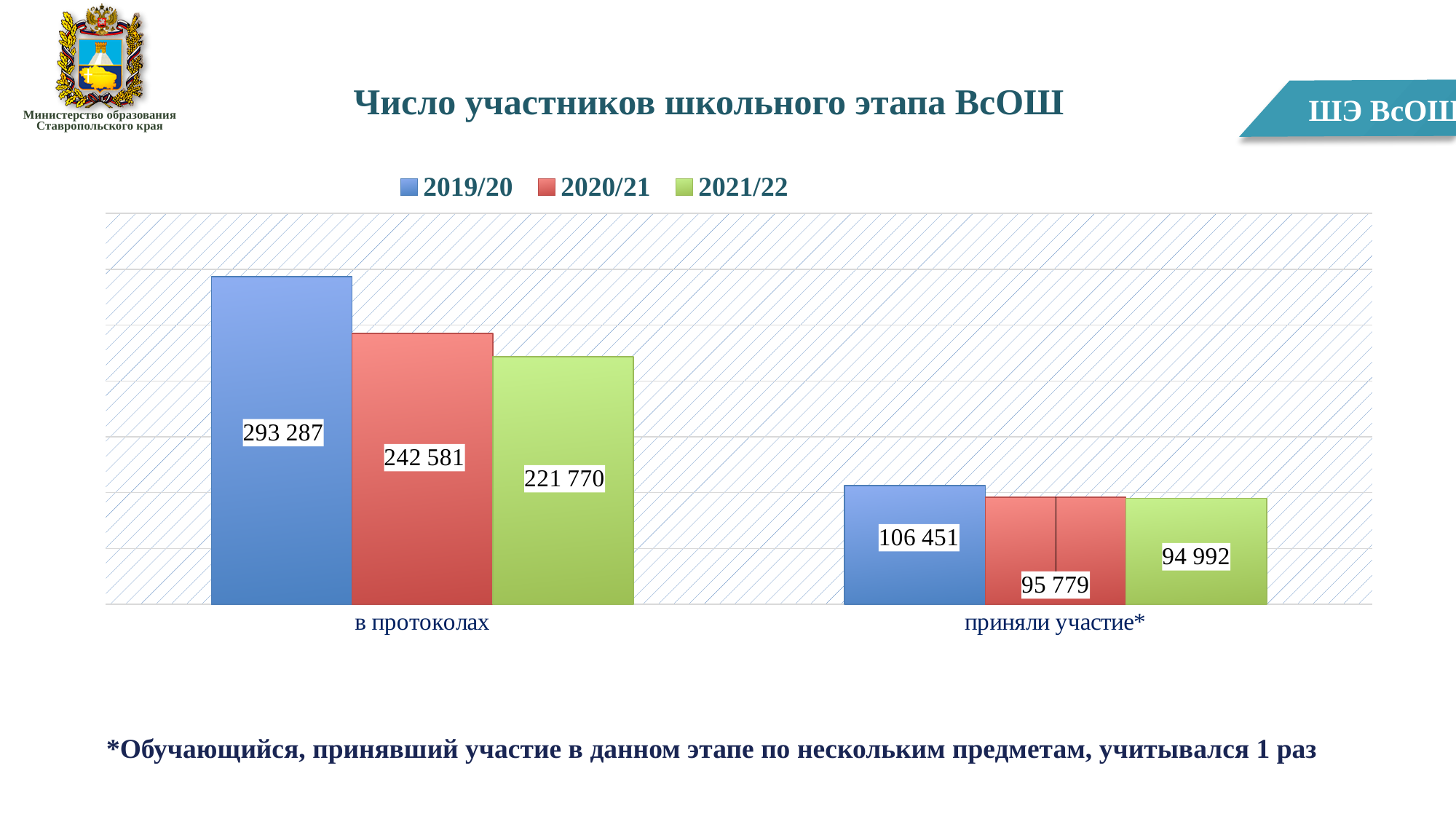
How many categories are shown on the x axis? 2 How many series does the legend list? 3 What is the difference between the 2019/20 and 2021/22 values in the "в протоколах" category? 71 517 Which series has the highest value in the "в протоколах" category? 2019/20 What is the value for 2020/21 in the "в протоколах" category? 242 581 Which series has the lowest value in the "приняли участие*" category? 2021/22 What is the title of the chart? Число участников школьного этапа ВсОШ What is the difference between the 2019/20 and 2020/21 values in the "приняли участие*" category? 10 672 What kind of chart is shown on the slide? Bar chart What is the value for 2019/20 in the "в протоколах" category? 293 287 Which is larger: the 2020/21 value for "в протоколах" or the 2019/20 value for "приняли участие*"? 2020/21 value for "в протоколах" What is the value for 2021/22 in the "приняли участие*" category? 94 992